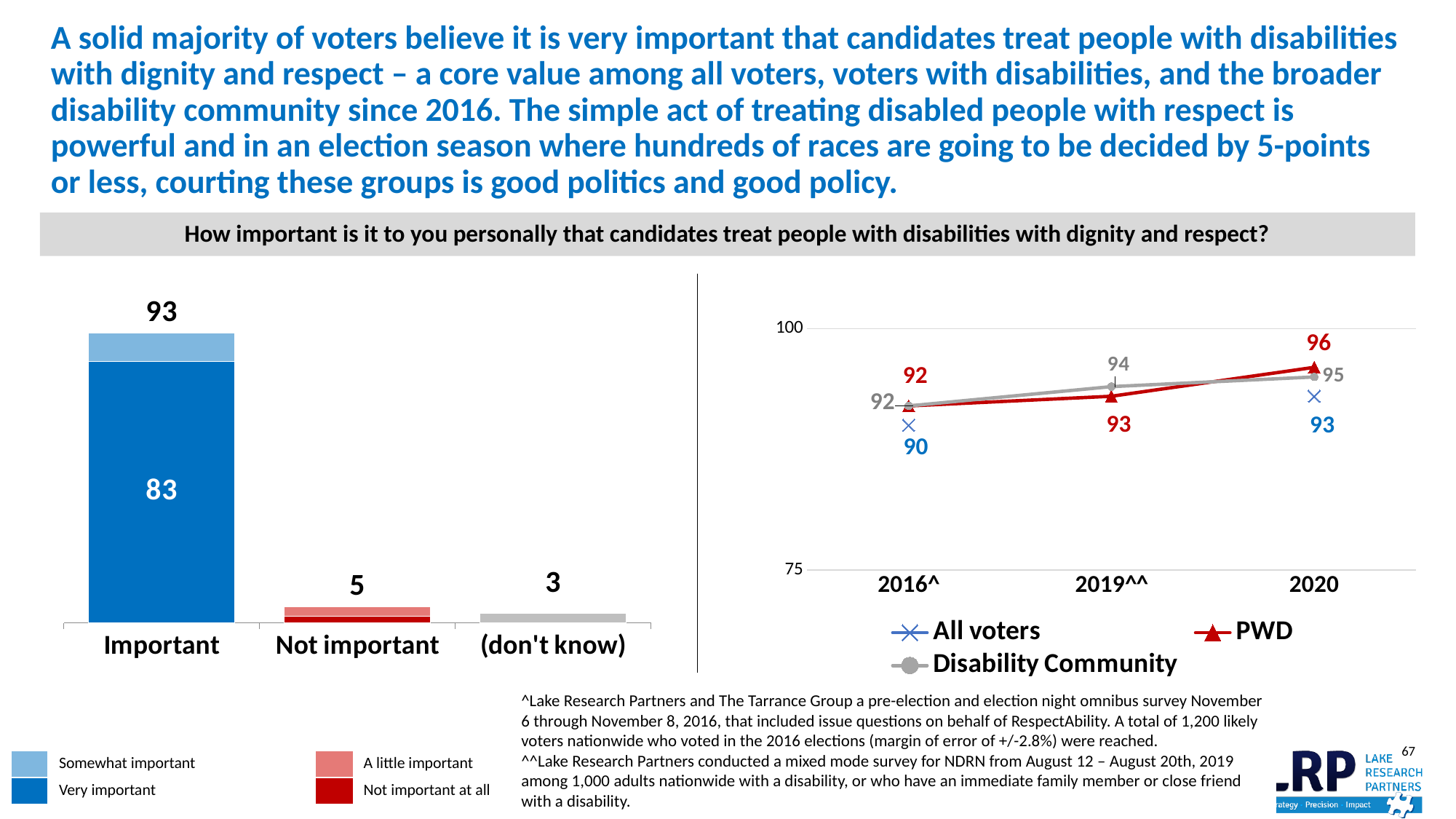
What type of chart is shown on the right side of the slide? line chart In the bar chart on the left, what is the value of the Very important segment of the Important bar? 83 In the bar chart on the left, what is the difference between the Important total and the Not important total? 88 In the line chart on the right, what is the value for All voters in 2016^? 90 In the bar chart on the left, which category has the lowest value? (don't know) In the line chart on the right, what is the value for PWD in 2020? 96 In the bar chart on the left, what is the value shown for Not important? 5 In the line chart on the right, how many series does the legend list? 3 In the line chart on the right, what is the value for Disability Community in 2019^^? 94 In the bar chart on the left, how many categories are shown on the x axis? 3 In the line chart on the right, does the PWD series rise or fall from 2016^ to 2020? rise In the bar chart on the left, what is the total value shown for the Important bar? 93